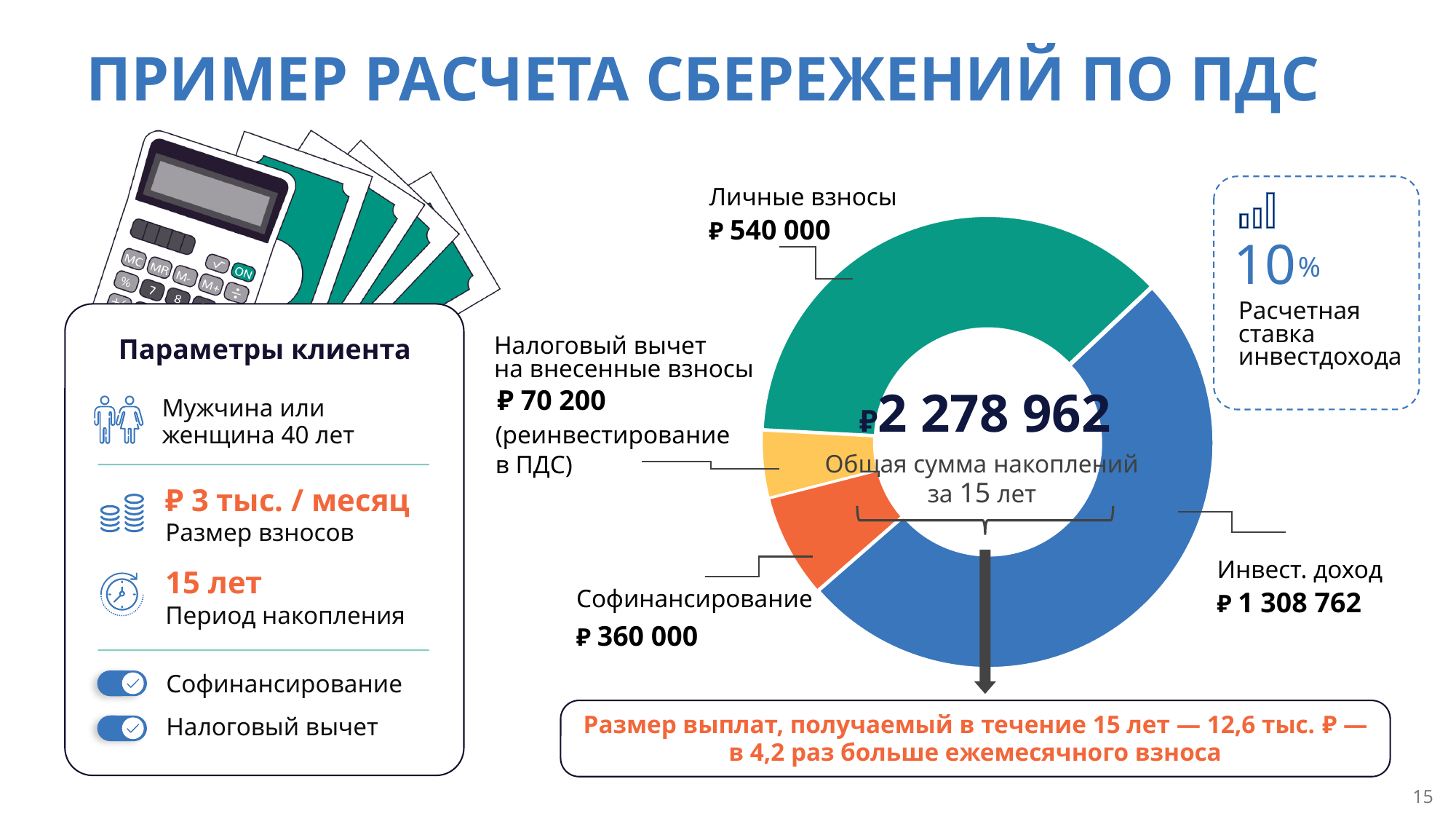
Which segment of the donut chart is the smallest? Налоговый вычет на внесенные взносы How many segments does the donut chart have? 4 What is the value of the Инвест. доход segment in the donut chart? ₽ 1 308 762 What is the difference between Личные взносы and Софинансирование in the donut chart? ₽ 180 000 What is the value of the Личные взносы segment in the donut chart? ₽ 540 000 What is the total sum shown in the centre of the donut chart (Общая сумма накоплений за 15 лет)? ₽2 278 962 What is the difference between Инвест. доход and Личные взносы in the donut chart? ₽ 768 762 Which is larger in the donut chart: Личные взносы or Софинансирование? Личные взносы What is the value of the Налоговый вычет на внесенные взносы segment in the donut chart? ₽ 70 200 Which segment of the donut chart is the largest? Инвест. доход What is the value of the Софинансирование segment in the donut chart? ₽ 360 000 What kind of chart is shown on the slide? donut (pie) chart